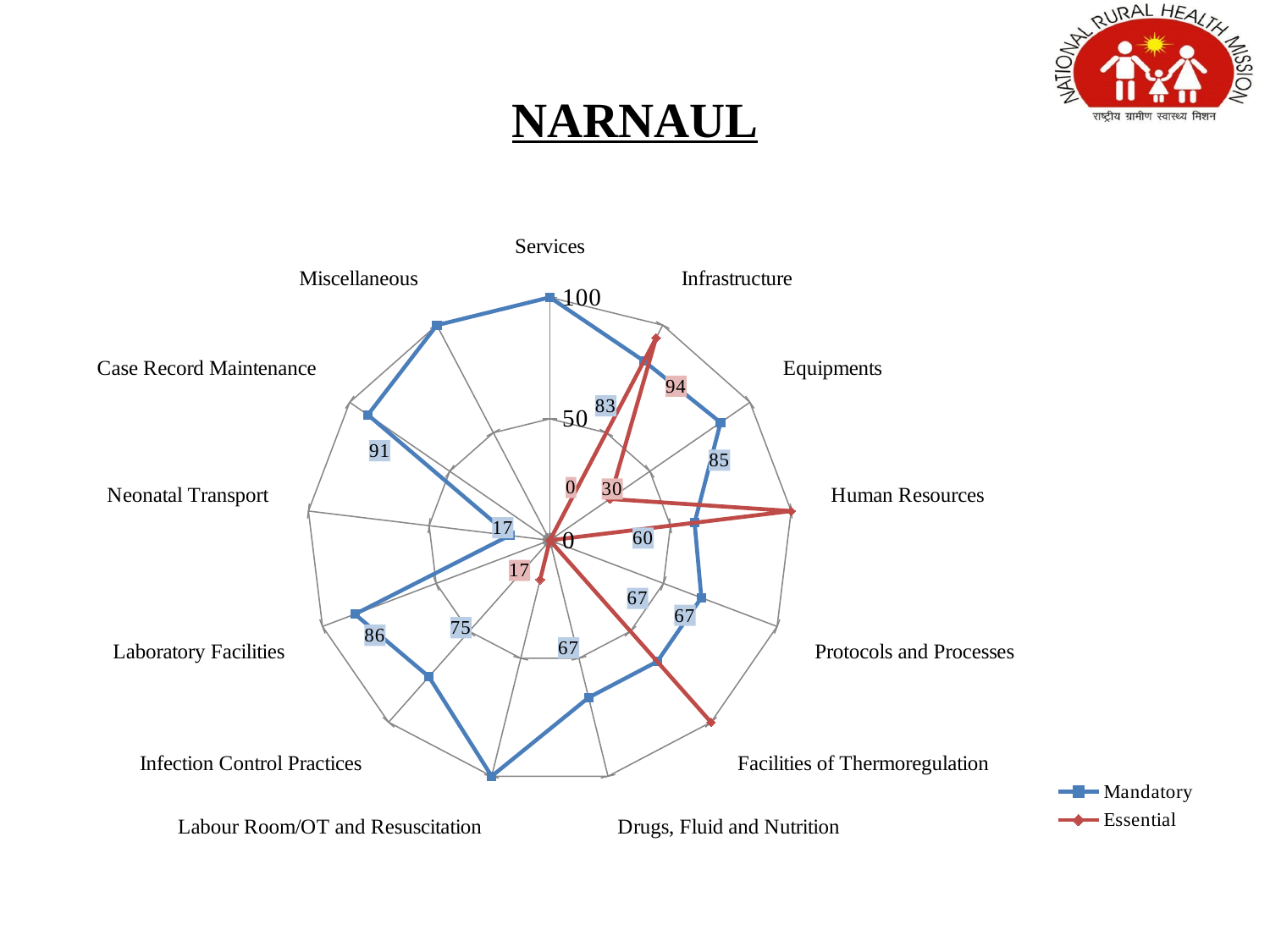
What is the difference between the Mandatory and Essential values for Infrastructure? 11 What is the Mandatory value for Laboratory Facilities? 86 What is the Mandatory value for Case Record Maintenance? 91 What is the Mandatory value for Neonatal Transport? 17 How many categories are plotted around the radar chart? 13 Is the Essential value for Services greater or less than 50? less How many series does the legend list? 2 What is the Mandatory value for Infrastructure? 83 What is the Essential value for Infrastructure? 94 What type of chart is shown on the slide? Radar chart Which category has the lowest Mandatory value? Neonatal Transport For Infrastructure, which series has the larger value, Mandatory or Essential? Essential